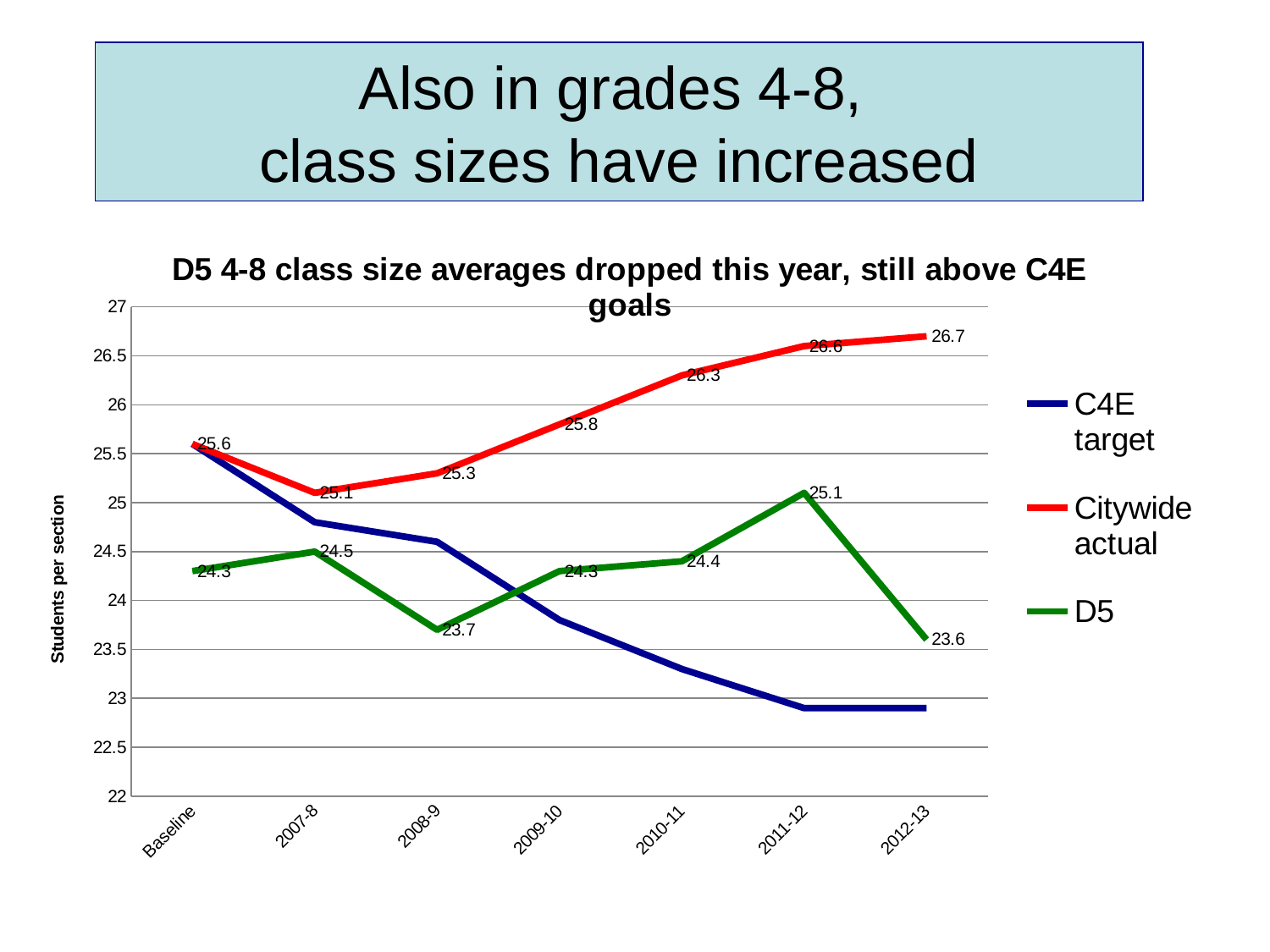
What type of chart is shown on the slide? line chart How many series does the legend list? 3 What is the Citywide actual value for 2012-13? 26.7 Does the C4E target series rise or fall from Baseline to 2012-13? fall Is the C4E target value at Baseline greater or less than 25? greater Which is larger in 2007-8, the Citywide actual value or the D5 value? Citywide actual What is the D5 value for 2011-12? 25.1 In which year does the D5 series reach its lowest value? 2012-13 How many points are plotted along the x axis for each series? 7 What is the D5 value for 2008-9? 23.7 What is the difference between the Citywide actual value and the D5 value in 2012-13? 3.1 In which year does the Citywide actual series reach its highest value? 2012-13